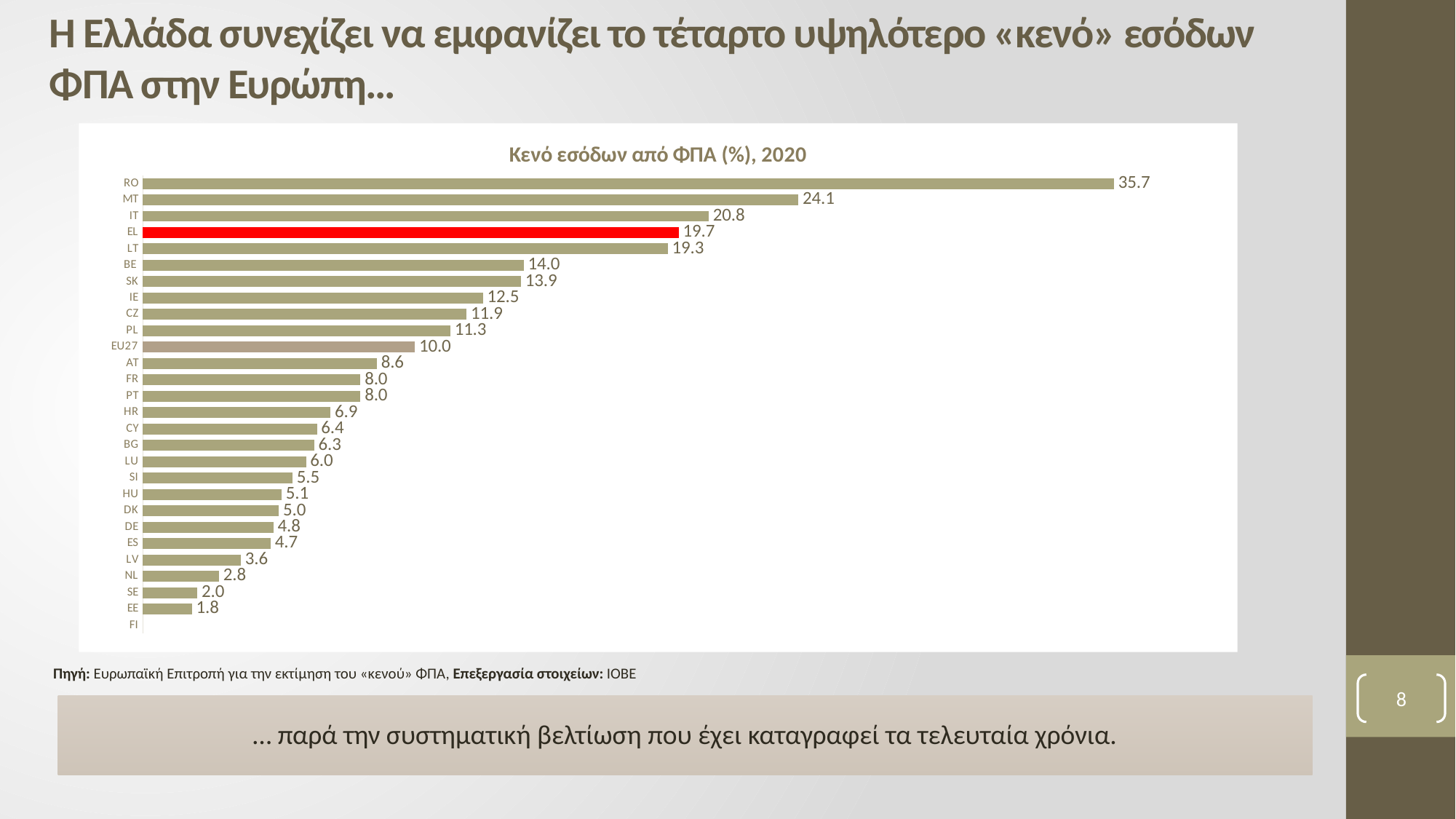
Which category's bar is coloured red in the chart? EL What is the value for EL in the chart? 19.7 What kind of chart is shown on the slide? Bar chart What is the value for DE in the chart? 4.8 What is the value for EU27 in the chart? 10.0 Which has a larger value, IT or LT? IT Which has a larger value, HR or SI? HR What is the difference between the values for EL and EU27? 9.7 What is the value for RO in the chart? 35.7 Which category has the highest value in the chart? RO How many categories are shown on the vertical axis of the chart? 28 What is the difference between the values for RO and MT? 11.6